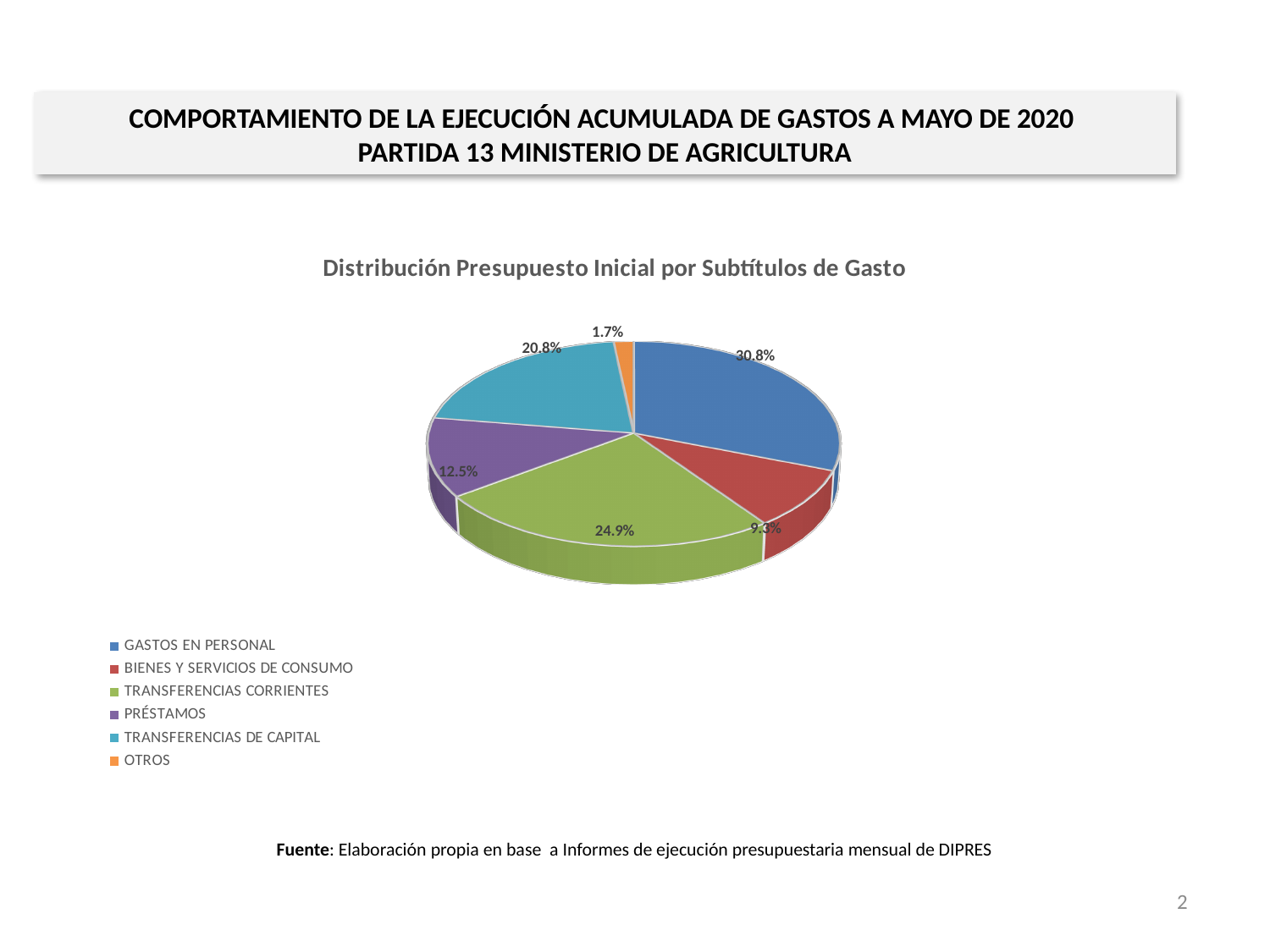
What is the difference in percentage points between GASTOS EN PERSONAL and TRANSFERENCIAS CORRIENTES? 5.9 What share of the pie does OTROS represent? 1.7% What is the title of the chart? Distribución Presupuesto Inicial por Subtítulos de Gasto What kind of chart is shown on the slide? Pie chart Which is larger, the slice for TRANSFERENCIAS DE CAPITAL or the slice for PRÉSTAMOS? TRANSFERENCIAS DE CAPITAL What share of the pie does TRANSFERENCIAS DE CAPITAL represent? 20.8% How many categories does the pie chart show? 6 Which category has the smallest slice of the pie? OTROS What share of the pie does GASTOS EN PERSONAL represent? 30.8% Which category has the largest slice of the pie? GASTOS EN PERSONAL What share of the pie does PRÉSTAMOS represent? 12.5% What share of the pie does TRANSFERENCIAS CORRIENTES represent? 24.9%